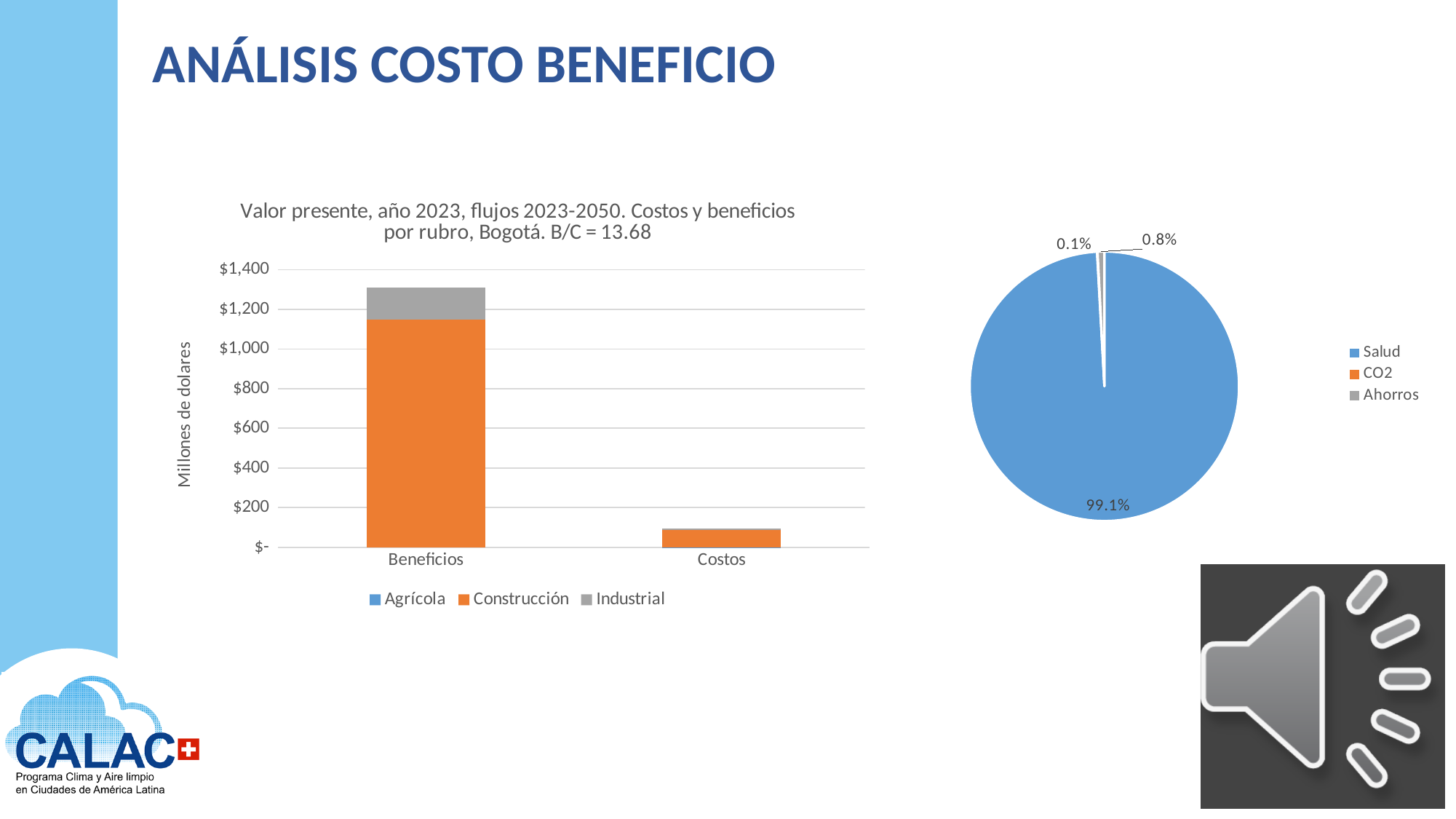
In the bar chart on the left, is the total value for Beneficios greater or less than $1,000? greater In the pie chart on the right, how many entries does the legend list? 3 In the bar chart on the left, what is the label of the y axis? Millones de dolares In the bar chart on the left, is the value for Costos greater or less than $200? less In the bar chart on the left, is the Construcción value for Beneficios greater or less than $1,000? greater In the bar chart on the left, how many series does the legend list? 3 In the bar chart on the left, which category has the taller bar, Beneficios or Costos? Beneficios What kind of chart is the chart on the right of the slide? pie chart What kind of chart is the chart on the left of the slide? bar chart In the pie chart on the right, what share does Salud have? 99.1% In the pie chart on the right, which slice is the largest? Salud In the bar chart on the left, how many categories are shown on the x axis? 2